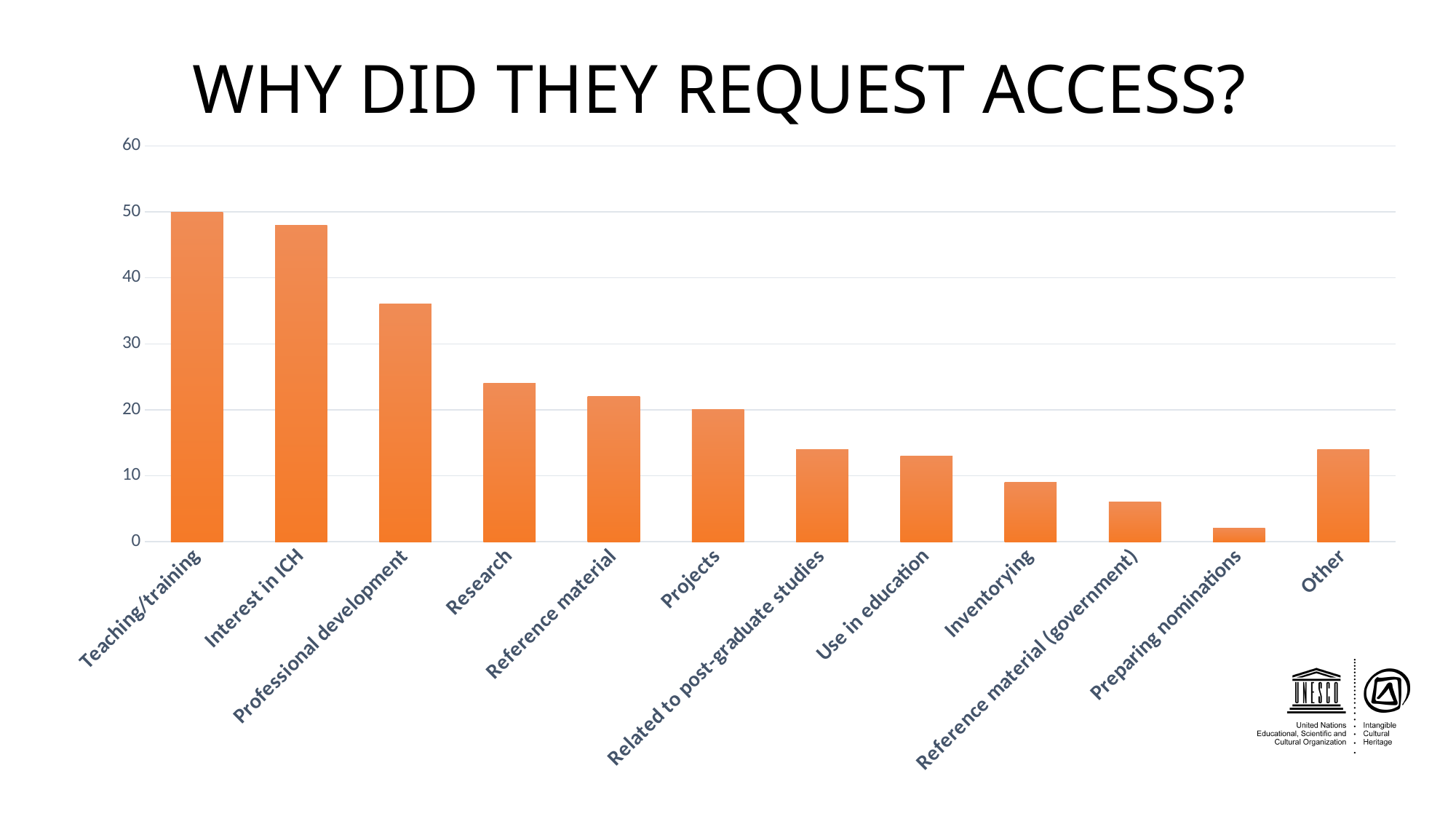
What is the value for Projects? 20 Is the value for Interest in ICH greater or less than 50? less Is the value for Professional development greater or less than 30? greater What is the title of the chart? WHY DID THEY REQUEST ACCESS? Is the value for Inventorying greater or less than 10? less What kind of chart is shown on the slide? bar chart How many categories are shown on the x axis? 12 What is the value for Teaching/training? 50 Which category has the highest value? Teaching/training Which is larger, the value for Research or the value for Use in education? Research Which is larger, the value for Other or the value for Reference material (government)? Other Which category has the lowest value? Preparing nominations